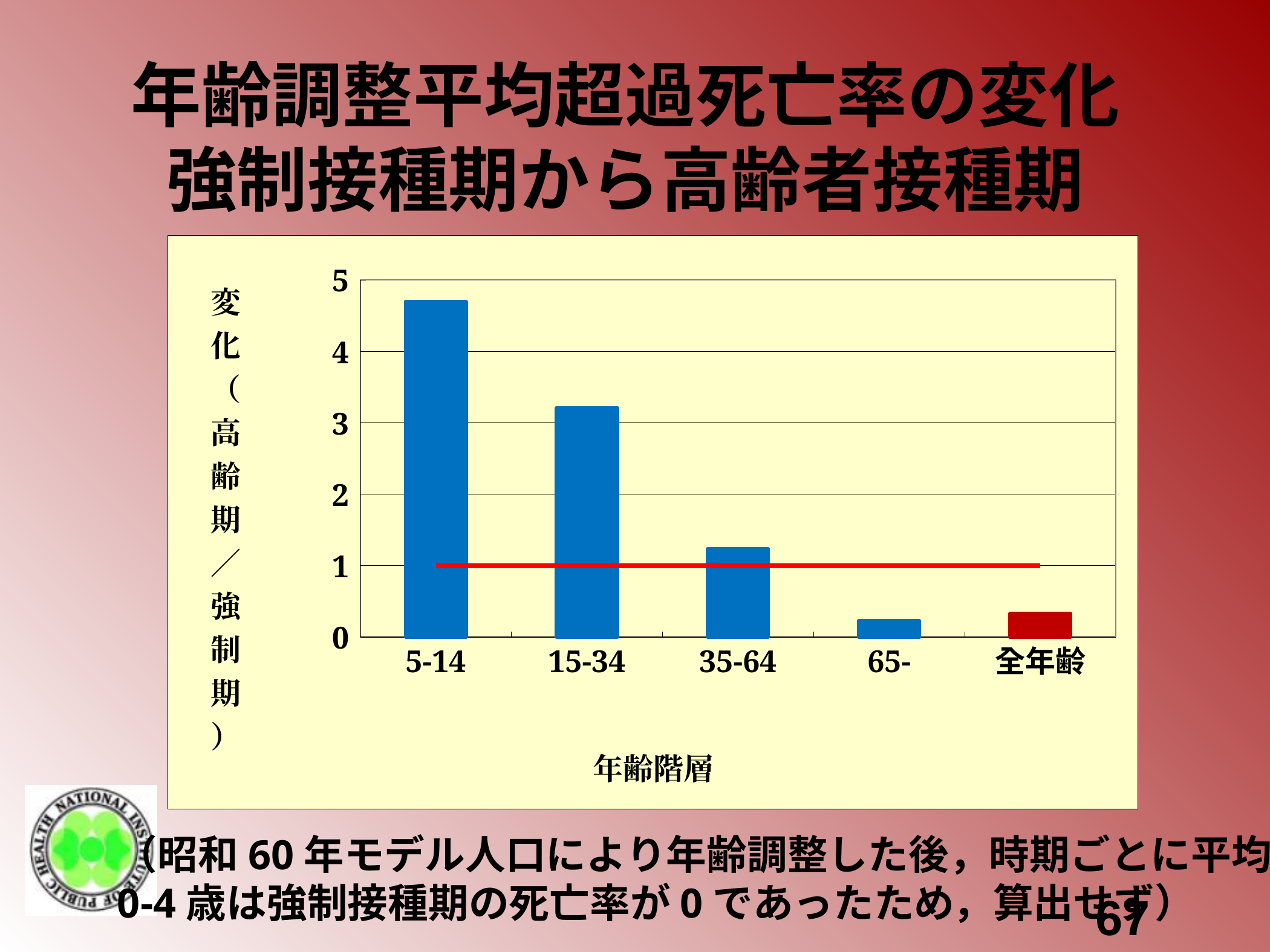
Which is larger, the value for 15-34 or the value for 35-64? 15-34 What kind of chart is shown on the slide? bar chart Is the value for 15-34 greater or less than 3? greater Which age group has the highest value in the chart? 5-14 How many categories are shown on the x axis of the chart? 5 Is the value for 35-64 greater or less than 2? less What is the x-axis title of the chart? 年齢階層 At what y-axis value is the horizontal red line drawn? 1 Is the value for 全年齢 greater or less than 1? less Do the values rise or fall from the 5-14 group to the 65- group? fall